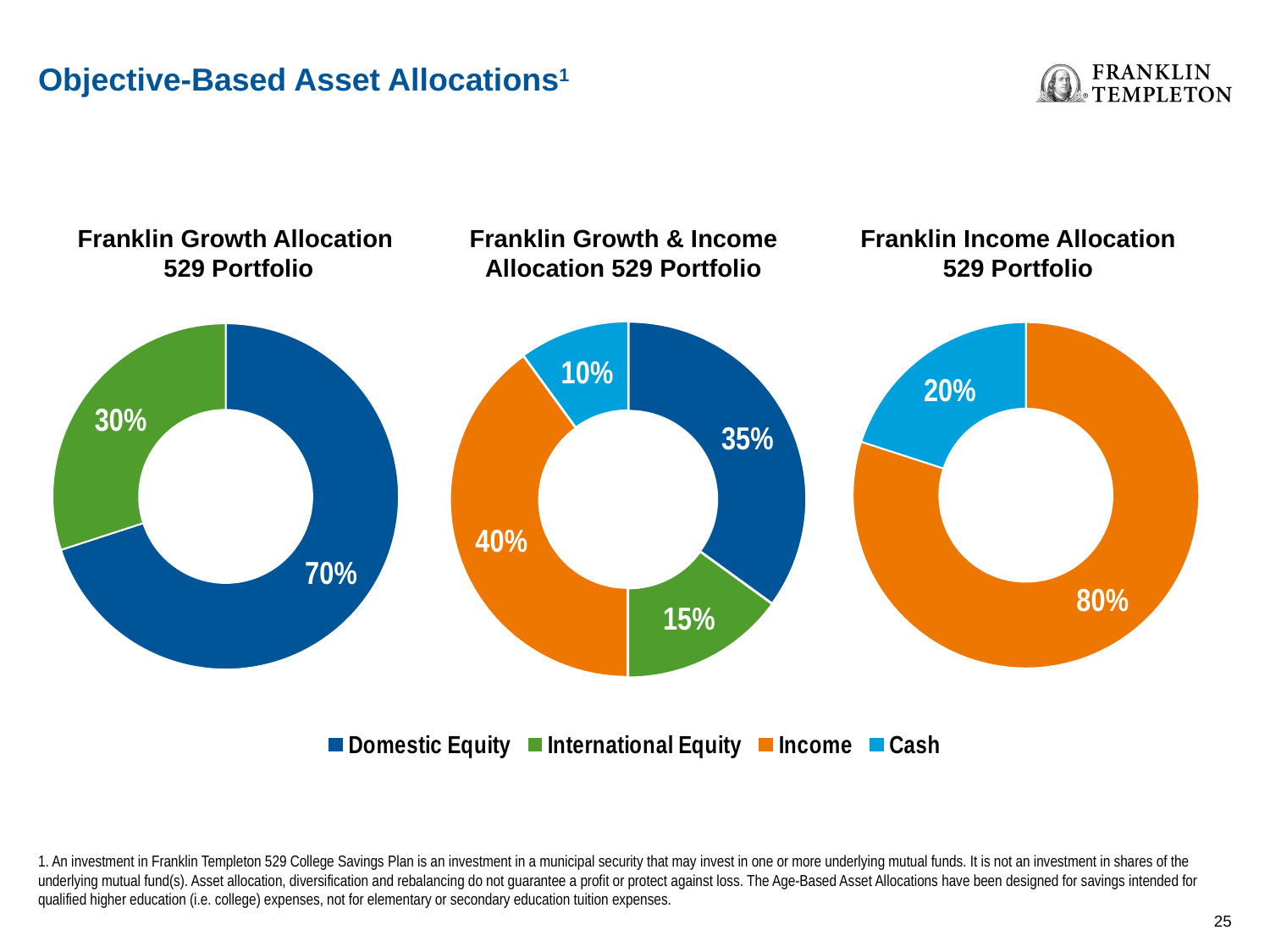
In the Franklin Income Allocation 529 Portfolio chart, which is larger, Income or Cash? Income In the Franklin Growth & Income Allocation 529 Portfolio chart, which category has the smallest share? Cash In the Franklin Income Allocation 529 Portfolio chart, what share is Income? 80% In the Franklin Growth & Income Allocation 529 Portfolio chart, which category has the largest share? Income What kind of chart is the Franklin Income Allocation 529 Portfolio chart? Doughnut (pie) chart In the Franklin Growth & Income Allocation 529 Portfolio chart, what is the difference between the Domestic Equity and International Equity shares? 20% How many categories are shown in the Franklin Growth & Income Allocation 529 Portfolio chart? 4 How many entries does the shared legend list? 4 In the Franklin Growth & Income Allocation 529 Portfolio chart, what share is Income? 40% In the Franklin Growth Allocation 529 Portfolio chart, what share is International Equity? 30% In the Franklin Growth Allocation 529 Portfolio chart, what share is Domestic Equity? 70% In the Franklin Growth & Income Allocation 529 Portfolio chart, what share is Cash? 10%